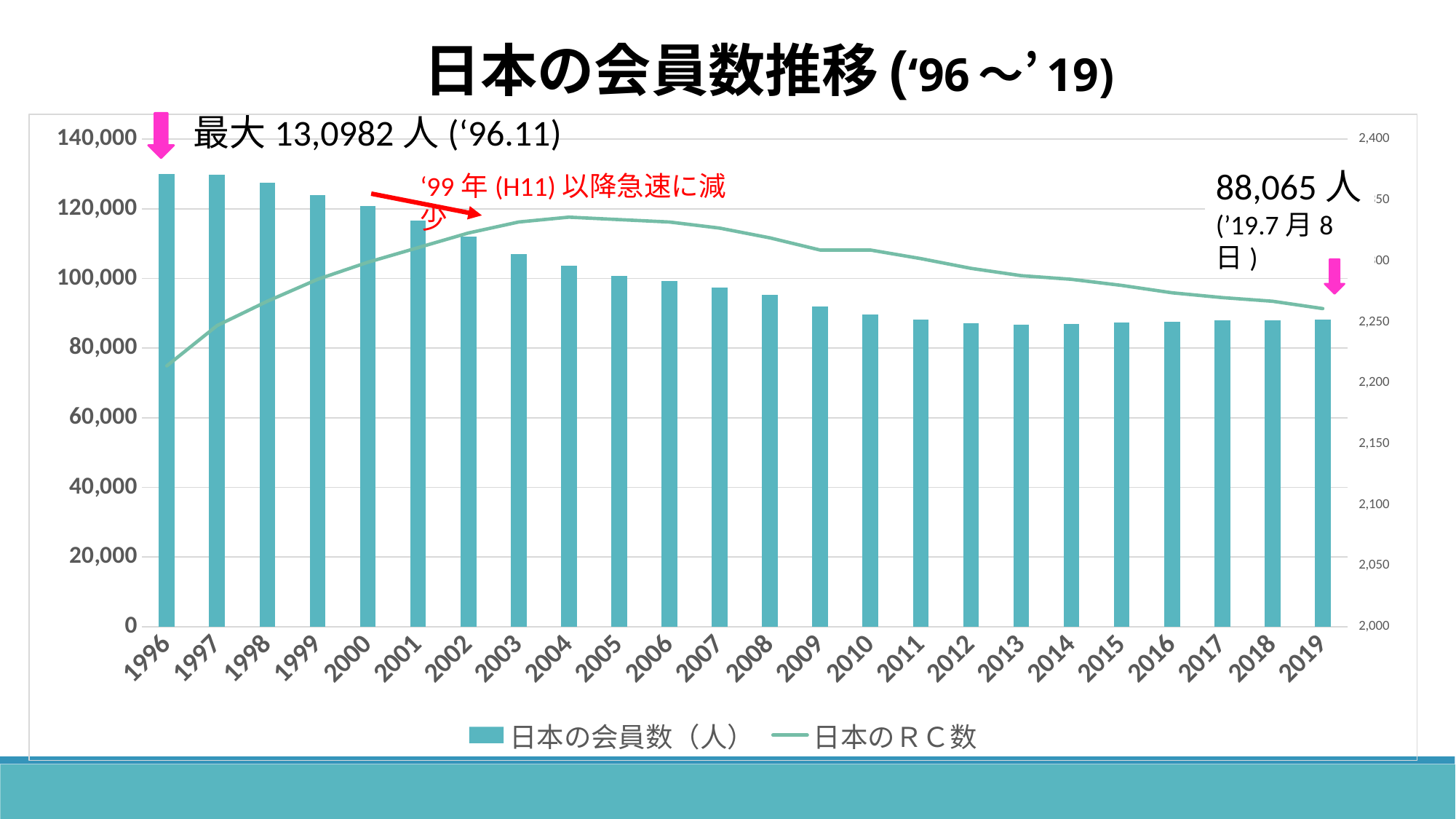
Is the 日本のＲＣ数 line value for 1996 greater or less than 2,250 on the right axis? less Is the 日本の会員数（人） value for 2010 greater or less than 100,000? less What kind of chart is shown on the slide? bar chart with a line Is the 日本の会員数（人） value for 2003 greater or less than 100,000? greater What are the two series named in the legend? 日本の会員数（人）, 日本のＲＣ数 Which year has the larger 日本の会員数（人） bar, 1996 or 2019? 1996 What is the value of 日本の会員数（人） for 2019 as annotated on the slide? 88,065 人 How many series does the legend list? 2 What is the title of the slide? 日本の会員数推移 ('96～'19) How many years are plotted along the x axis? 24 Do the 日本の会員数（人） bars rise or fall from 1996 to 2019? fall